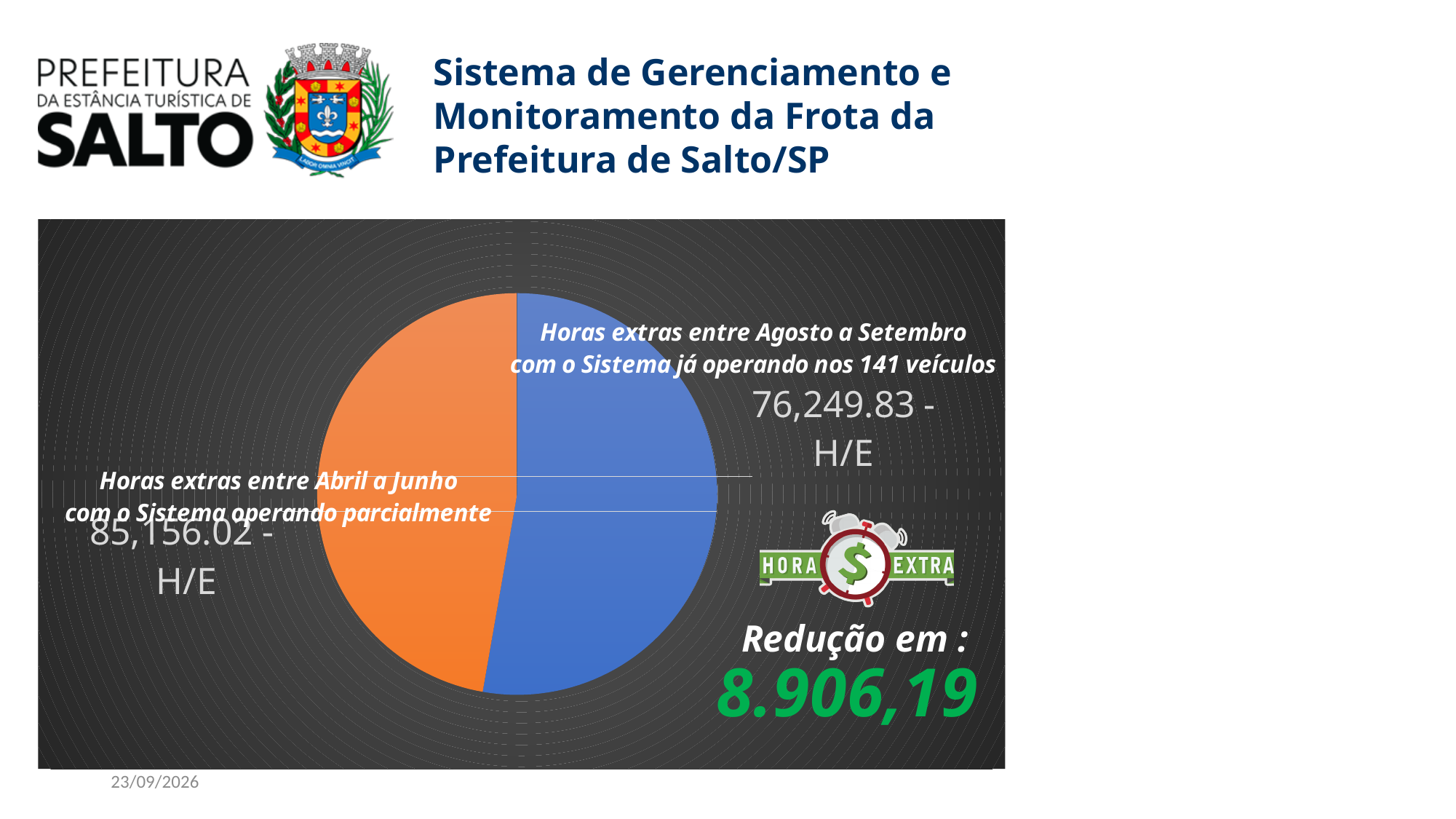
What colour is the slice for Abril a Junho? orange Which period has the smaller number of overtime hours (H/E) in the pie chart? Agosto a Setembro Which period has the larger number of overtime hours (H/E) in the pie chart? Abril a Junho What value is shown for the slice 'Horas extras entre Agosto a Setembro com o Sistema já operando nos 141 veículos'? 76,249.83 - H/E How many slices does the pie chart have? 2 Is the value for Abril a Junho larger or smaller than the value for Agosto a Setembro? larger What value is shown for the slice 'Horas extras entre Abril a Junho com o Sistema operando parcialmente'? 85,156.02 - H/E What is the difference between the Abril a Junho value and the Agosto a Setembro value? 8,906.19 What colour is the slice for Agosto a Setembro? blue What kind of chart is shown on the slide? pie chart